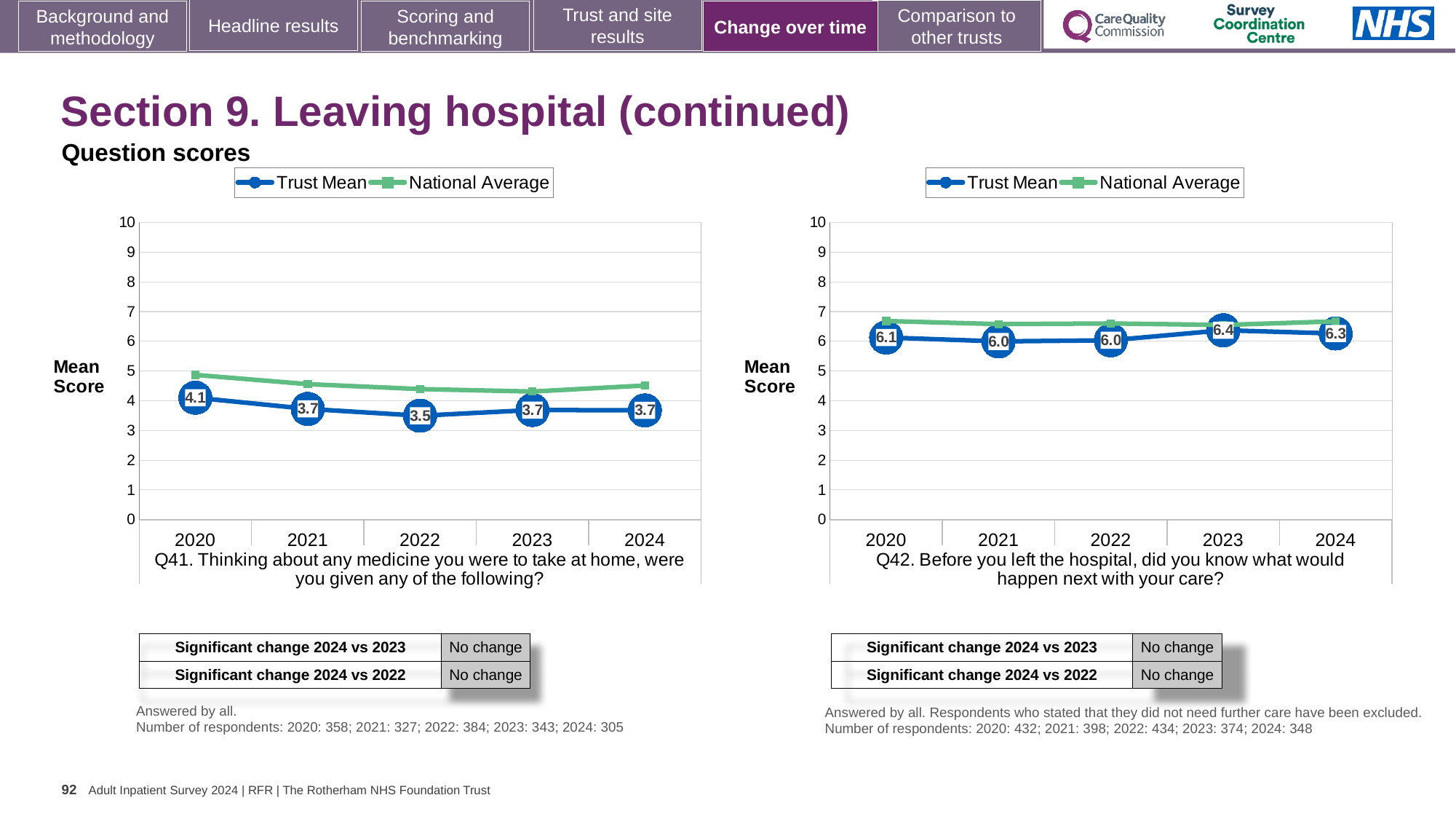
In the Q42 chart on the right, what is the Trust Mean score for 2024? 6.3 How many series does the legend of the Q41 chart on the left list? 2 What kind of chart is the Q42 chart on the right? Line chart In the Q41 chart on the left, which year has the lowest Trust Mean score? 2022 In the Q42 chart on the right, what is the difference between the Trust Mean scores for 2023 and 2020? 0.3 In the Q42 chart on the right, is the National Average for 2022 greater or less than 7? less In the Q42 chart on the right, what is the Trust Mean score for 2023? 6.4 In the Q41 chart on the left, what is the Trust Mean score for 2022? 3.5 In the Q41 chart on the left, what is the Trust Mean score for 2020? 4.1 In the Q41 chart on the left, is the National Average for 2020 greater or less than 4? greater In the Q42 chart on the right, which year has the highest Trust Mean score? 2023 In the Q41 chart on the left, which year has the highest Trust Mean score? 2020